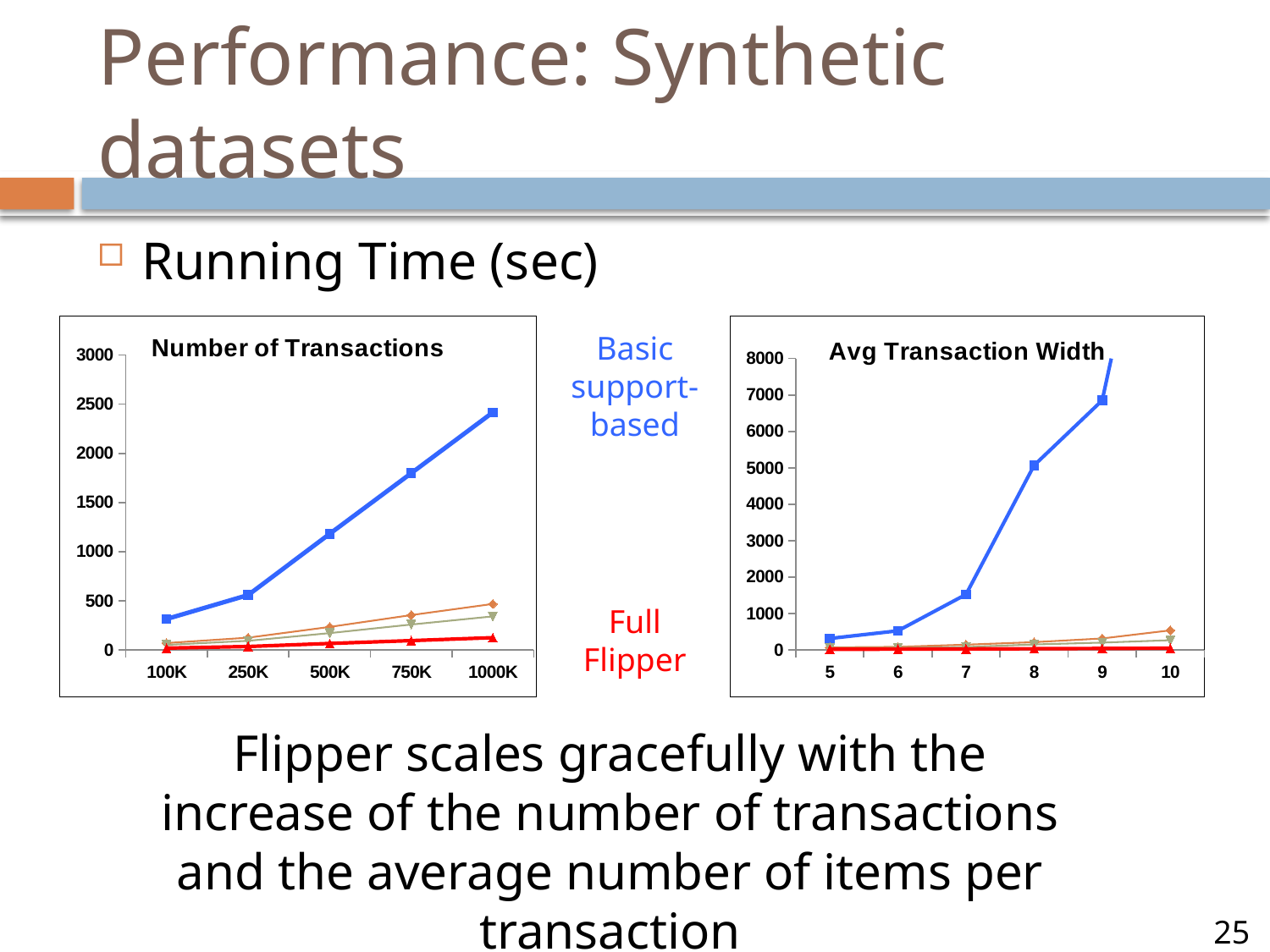
What kind of chart is the "Number of Transactions" chart? line chart In the "Number of Transactions" chart, is the Basic support-based value at 100K greater or less than 500? less How many x-axis categories does the "Number of Transactions" chart have? 5 How many x-axis categories does the "Avg Transaction Width" chart have? 6 In the "Number of Transactions" chart, is the Basic support-based value at 750K greater or less than 1500? greater In the "Number of Transactions" chart, which series has the highest value at 1000K? Basic support-based In the "Avg Transaction Width" chart, is the Basic support-based value at 5 greater or less than 1000? less In the "Number of Transactions" chart, does the Basic support-based line rise or fall as the number of transactions increases? rise What kind of chart is the "Avg Transaction Width" chart? line chart In the "Avg Transaction Width" chart, which is larger at width 9: Basic support-based or Full Flipper? Basic support-based